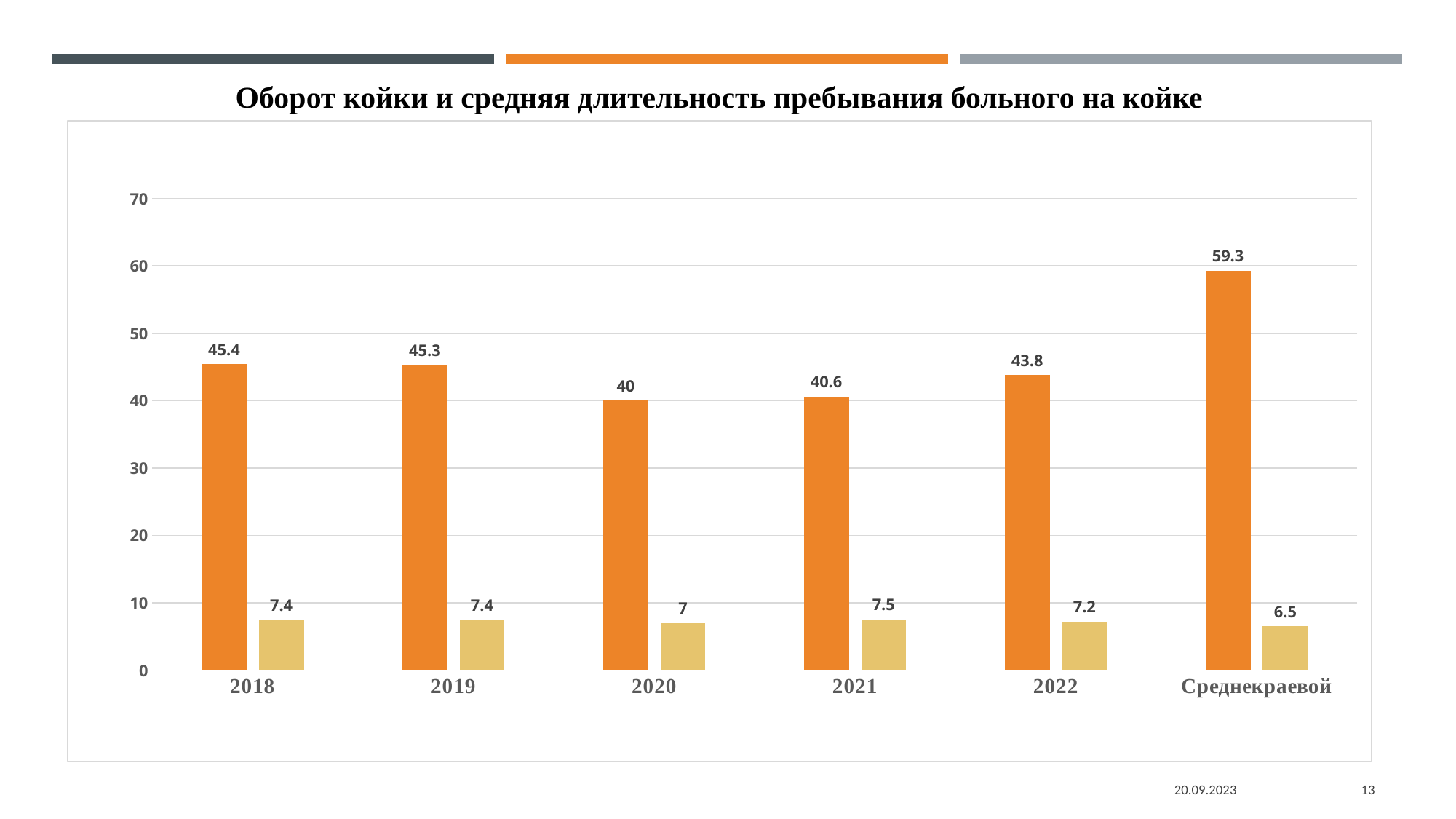
What is the title of the chart? Оборот койки и средняя длительность пребывания больного на койке Which category has the highest orange bar? Среднекраевой What is the value of the yellow bar for 2021? 7.5 Which is larger: the orange bar for 2021 or the orange bar for 2020? 2021 What is the difference between the orange bar for Среднекраевой and the orange bar for 2022? 15.5 Which category has the lowest yellow bar? Среднекраевой What kind of chart is shown on the slide? Bar chart What is the value of the orange bar for Среднекраевой? 59.3 What is the value of the orange bar for 2018? 45.4 Which category has the lowest orange bar? 2020 How many categories are shown on the x axis? 6 What is the value of the yellow bar for 2020? 7